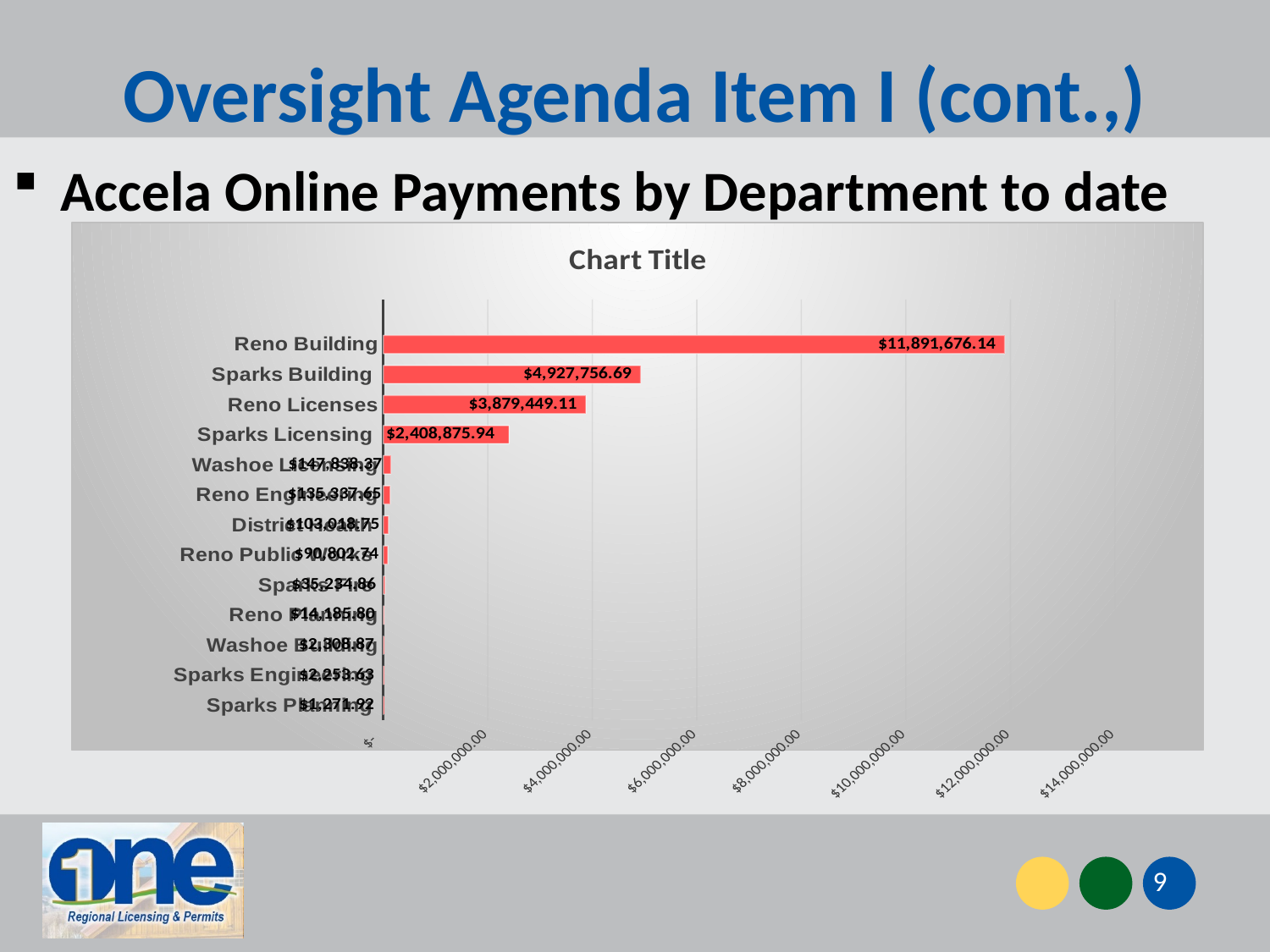
What is the difference between the values for Sparks Building and Reno Licenses? $1,048,307.58 What type of chart is shown on the slide? bar chart Which is larger, the value for Reno Licenses or the value for Sparks Licensing? Reno Licenses What is the value for Reno Building? $11,891,676.14 What is the value for Reno Licenses? $3,879,449.11 What is the difference between the values for Reno Building and Sparks Building? $6,963,919.45 How many departments are shown in the chart? 13 Is the value for Reno Building greater or less than $10,000,000.00? greater What is the value for Sparks Building? $4,927,756.69 Which department has the highest value? Reno Building What is the value for Sparks Licensing? $2,408,875.94 What is the title shown above the chart? Chart Title